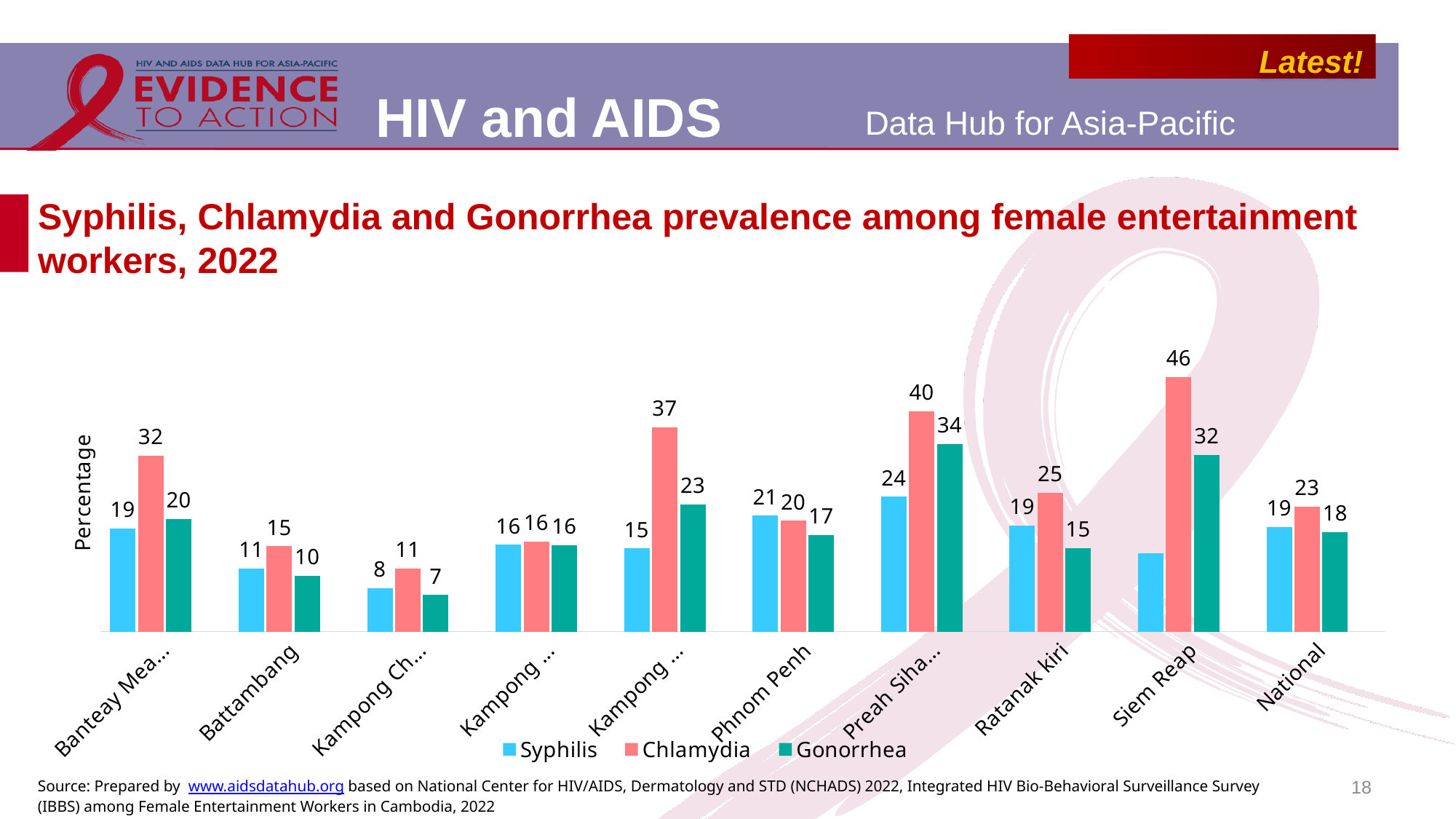
How many series does the legend list? 3 What is the Syphilis prevalence for Phnom Penh? 21 What is the Chlamydia prevalence for Siem Reap? 46 How many categories are shown on the x axis? 10 What kind of chart is shown on the slide? Bar chart Which is larger for Battambang, the Chlamydia prevalence or the Gonorrhea prevalence? Chlamydia What is the Gonorrhea prevalence for Ratanak kiri? 15 What is the National Chlamydia prevalence? 23 Which category has the lowest Gonorrhea prevalence? Kampong Ch... What is the label of the vertical axis? Percentage Which category has the highest Chlamydia prevalence? Siem Reap